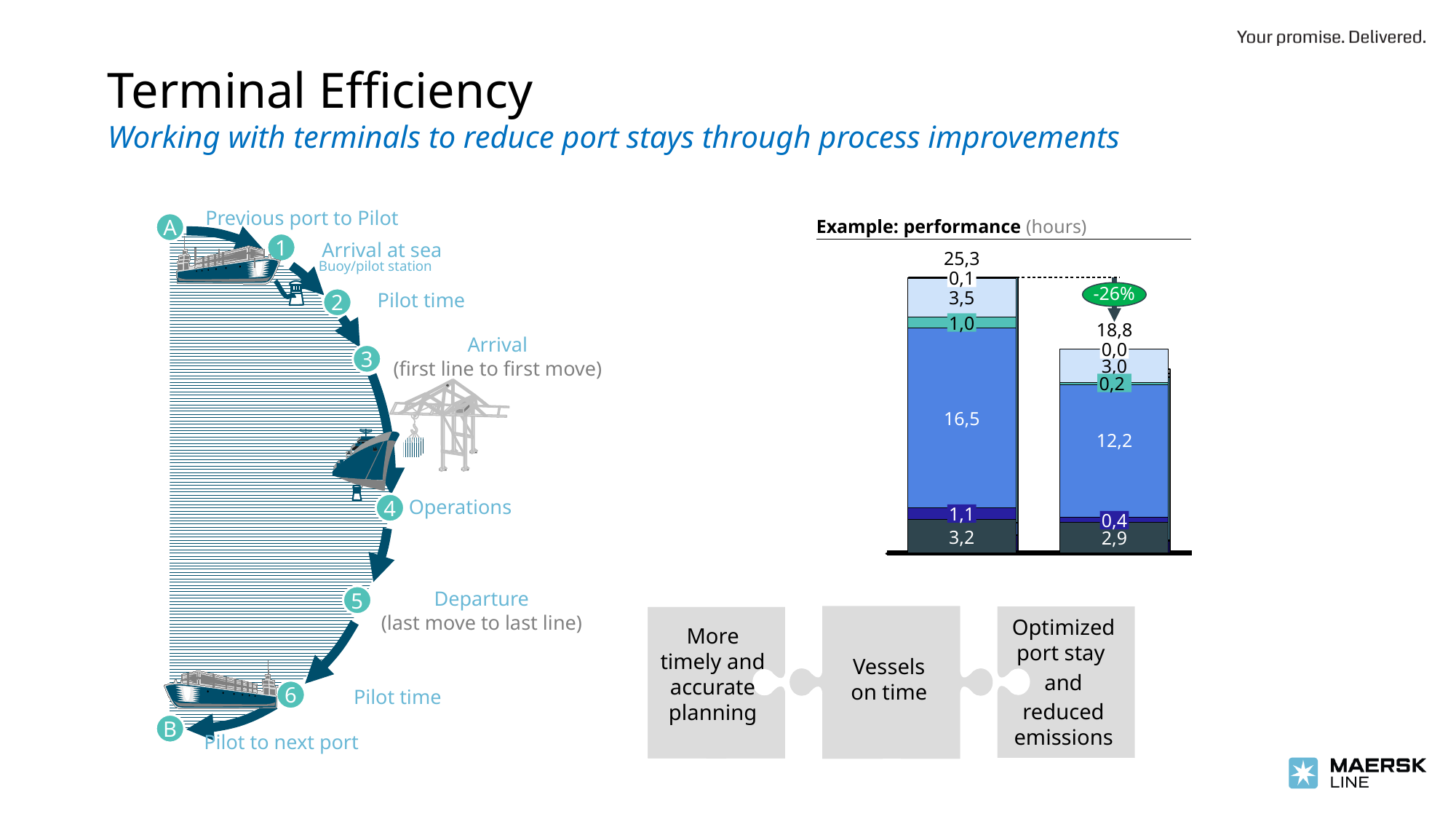
What kind of chart is shown under "Example: performance (hours)"? stacked bar chart Do the bar totals rise or fall from the left bar to the right bar in the "Example: performance (hours)" chart? fall What is the total of the left bar in the "Example: performance (hours)" chart? 25,3 What percentage change is annotated between the two bars in the "Example: performance (hours)" chart? -26% What is the difference between the totals of the left bar and the right bar in the "Example: performance (hours)" chart? 6,5 What is the value of the bottom (dark) segment of the right bar in the "Example: performance (hours)" chart? 2,9 How many bars does the "Example: performance (hours)" chart show? 2 What is the value of the largest segment in the right bar of the "Example: performance (hours)" chart? 12,2 What is the total of the right bar in the "Example: performance (hours)" chart? 18,8 Which bar in the "Example: performance (hours)" chart has the larger total, the left or the right? left What is the value of the largest segment in the left bar of the "Example: performance (hours)" chart? 16,5 What is the difference between the largest segment of the left bar (16,5) and the largest segment of the right bar (12,2) in the "Example: performance (hours)" chart? 4,3